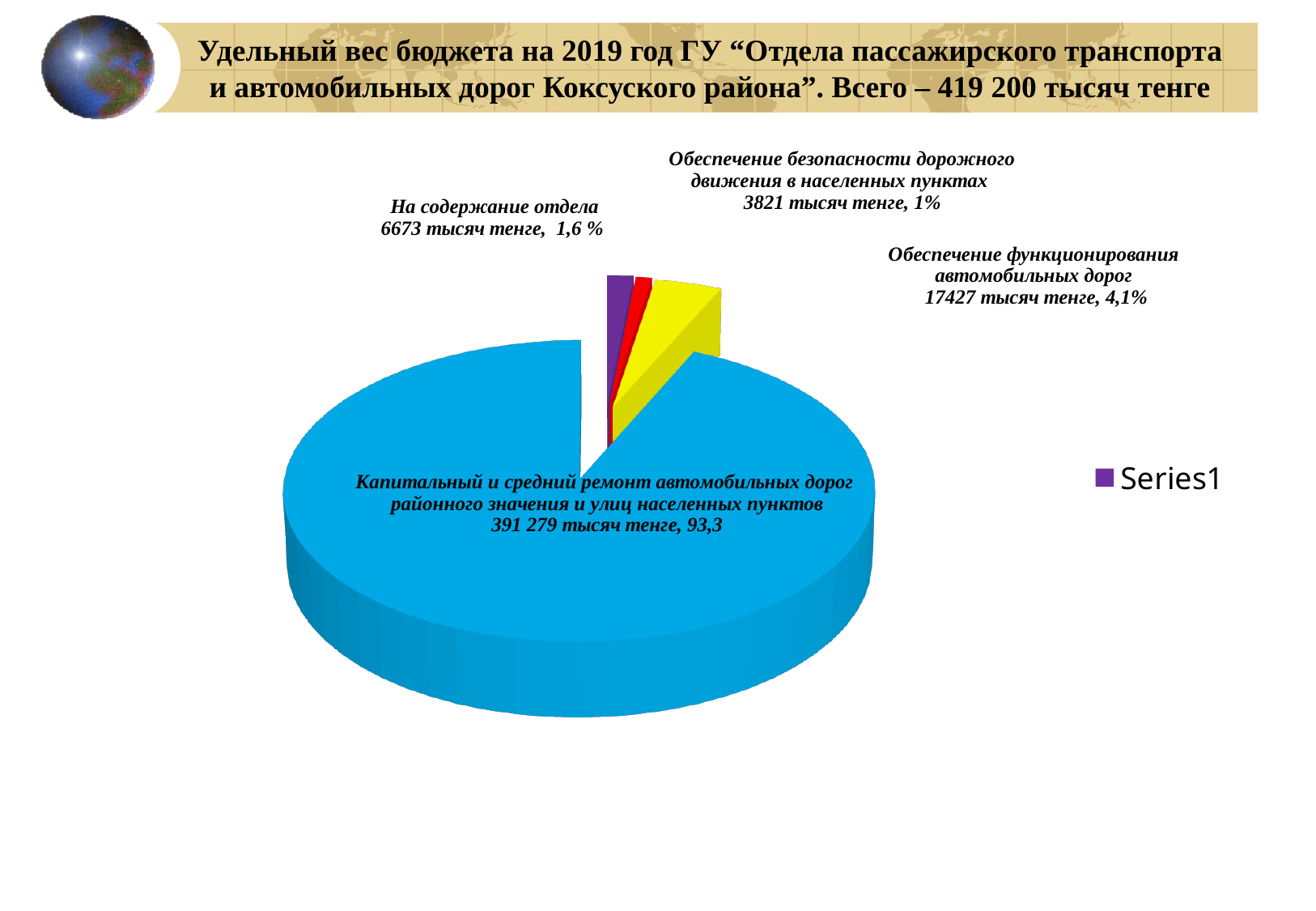
What is the difference between the values for "Обеспечение функционирования автомобильных дорог" and "На содержание отдела"? 10754 тысяч тенге What share of the pie does "На содержание отдела" represent? 1,6 % What is the value for "Обеспечение безопасности дорожного движения в населенных пунктах"? 3821 тысяч тенге What is the value for "Обеспечение функционирования автомобильных дорог"? 17427 тысяч тенге What share of the pie does "Обеспечение функционирования автомобильных дорог" represent? 4,1% What kind of chart is shown on the slide? pie chart How many slices does the pie chart have? 4 Which is larger: the value for "На содержание отдела" or for "Обеспечение безопасности дорожного движения в населенных пунктах"? На содержание отдела What is the value for "На содержание отдела"? 6673 тысяч тенге Which category has the smallest slice of the pie? Обеспечение безопасности дорожного движения в населенных пунктах What is the value for "Капитальный и средний ремонт автомобильных дорог районного значения и улиц населенных пунктов"? 391 279 тысяч тенге Which category has the largest slice of the pie? Капитальный и средний ремонт автомобильных дорог районного значения и улиц населенных пунктов